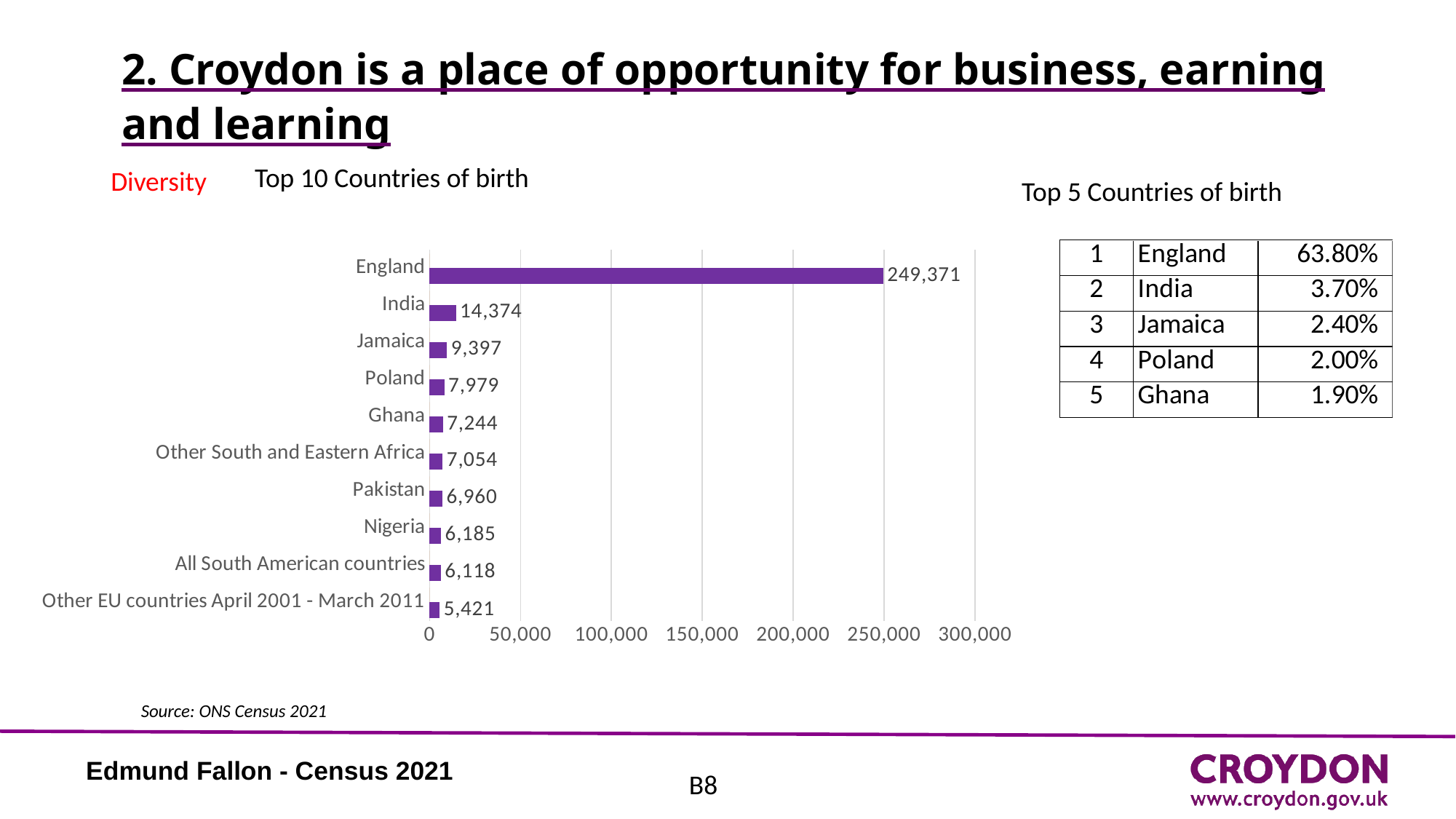
What is the value for Jamaica in the Top 10 Countries of birth chart? 9,397 What kind of chart is the Top 10 Countries of birth chart? bar chart What is the difference between the values for Poland and Ghana in the Top 10 Countries of birth chart? 735 How many categories are shown in the Top 10 Countries of birth chart? 10 Which has a larger value in the Top 10 Countries of birth chart, Nigeria or All South American countries? Nigeria Which category has the lowest value in the Top 10 Countries of birth chart? Other EU countries April 2001 - March 2011 What is the difference between the values for India and Jamaica in the Top 10 Countries of birth chart? 4,977 What is the value for Pakistan in the Top 10 Countries of birth chart? 6,960 What is the value for England in the Top 10 Countries of birth chart? 249,371 Is the value for England in the Top 10 Countries of birth chart greater or less than 200,000? greater Which country has the highest value in the Top 10 Countries of birth chart? England What is the value for Other EU countries April 2001 - March 2011 in the Top 10 Countries of birth chart? 5,421